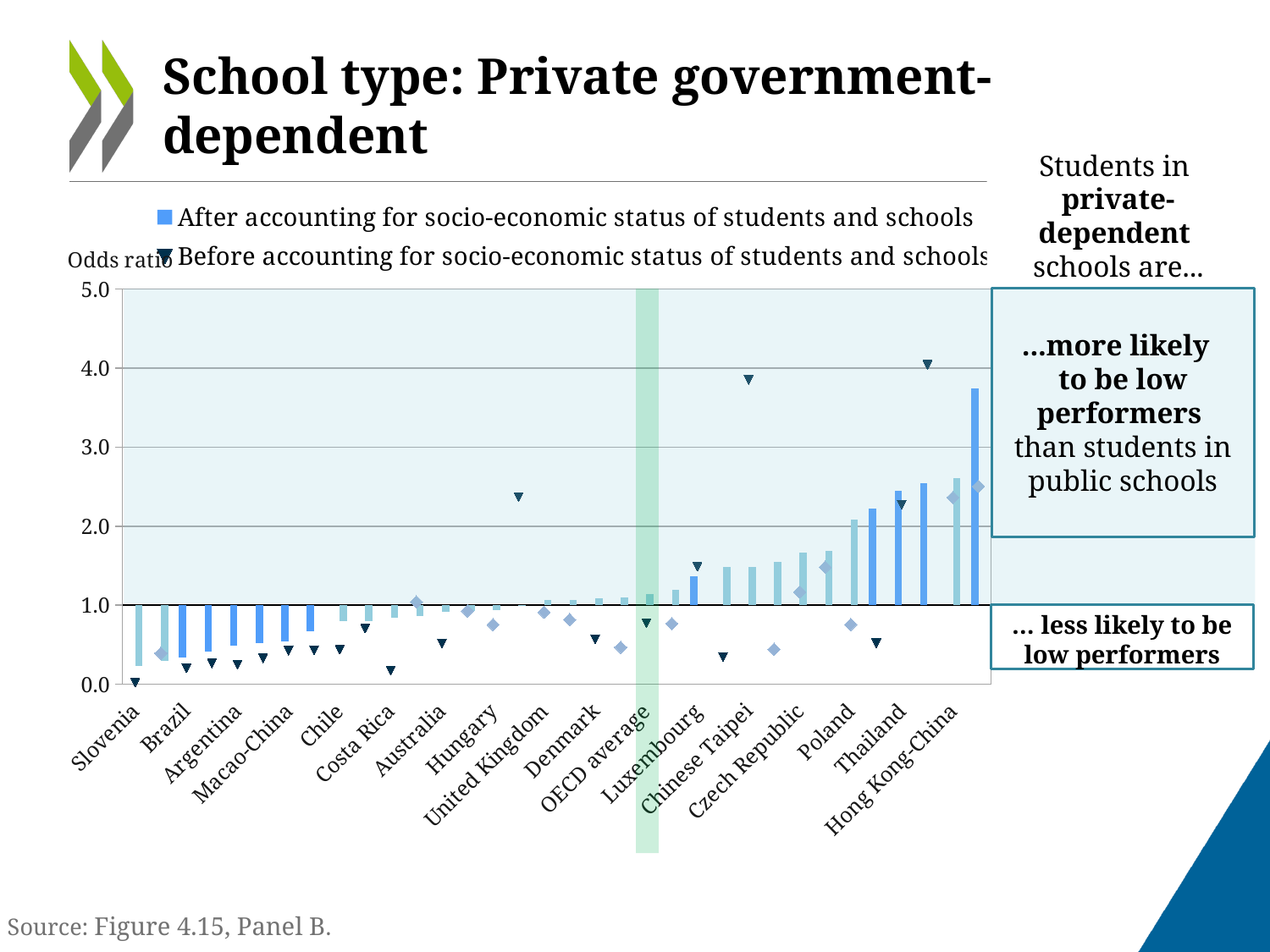
What is the label of the vertical axis? Odds ratio Do the 'After accounting for socio-economic status' bars generally rise or fall from left to right along the x axis? rise What kind of chart is shown on the slide? bar chart Is the 'After accounting for socio-economic status' value for Hong Kong-China greater or less than 2.0? greater Which category is highlighted with a green vertical band? OECD average Is the 'After accounting for socio-economic status' value for Slovenia greater or less than 1.0? less Which has the larger 'After accounting for socio-economic status' value, Thailand or Slovenia? Thailand Which is larger for Chinese Taipei: the value before or after accounting for socio-economic status? before Is the 'After accounting for socio-economic status' value for Thailand greater or less than 2.0? greater How many series does the legend list? 2